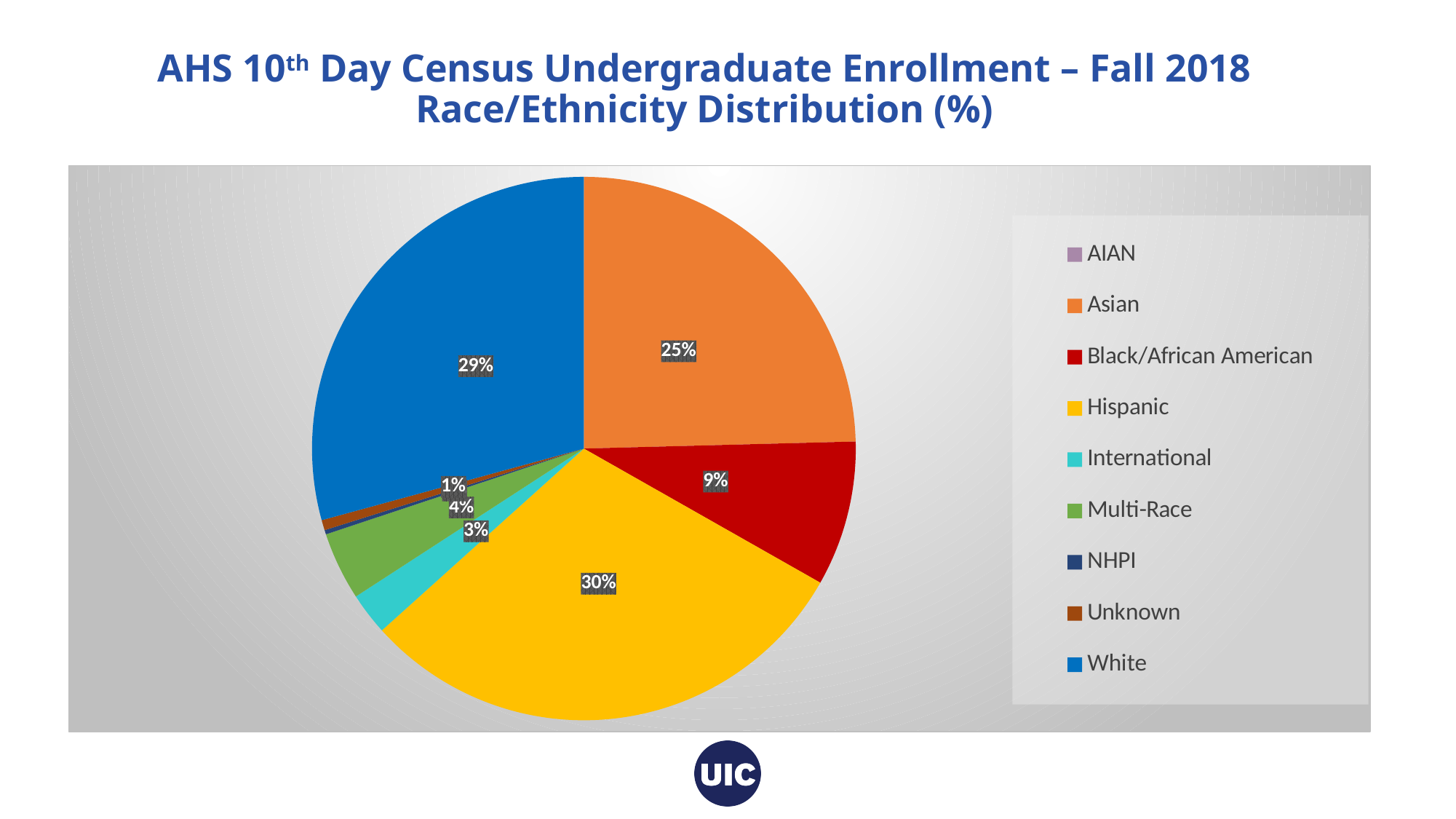
What percentage is shown for International? 3% What percentage is shown for Black/African American? 9% What is the title of the chart on the slide? AHS 10th Day Census Undergraduate Enrollment – Fall 2018 Race/Ethnicity Distribution (%) How many categories are listed in the legend? 9 Which slice is larger, Asian or White? White What percentage is shown for the Asian slice? 25% What percentage is shown for the White slice? 29% What percentage is shown for Multi-Race? 4% How many percentage points larger is the Hispanic slice than the Asian slice? 5% Which race/ethnicity category has the largest share of the pie? Hispanic What kind of chart is shown on the slide? pie chart What percentage of the pie is the Hispanic slice? 30%